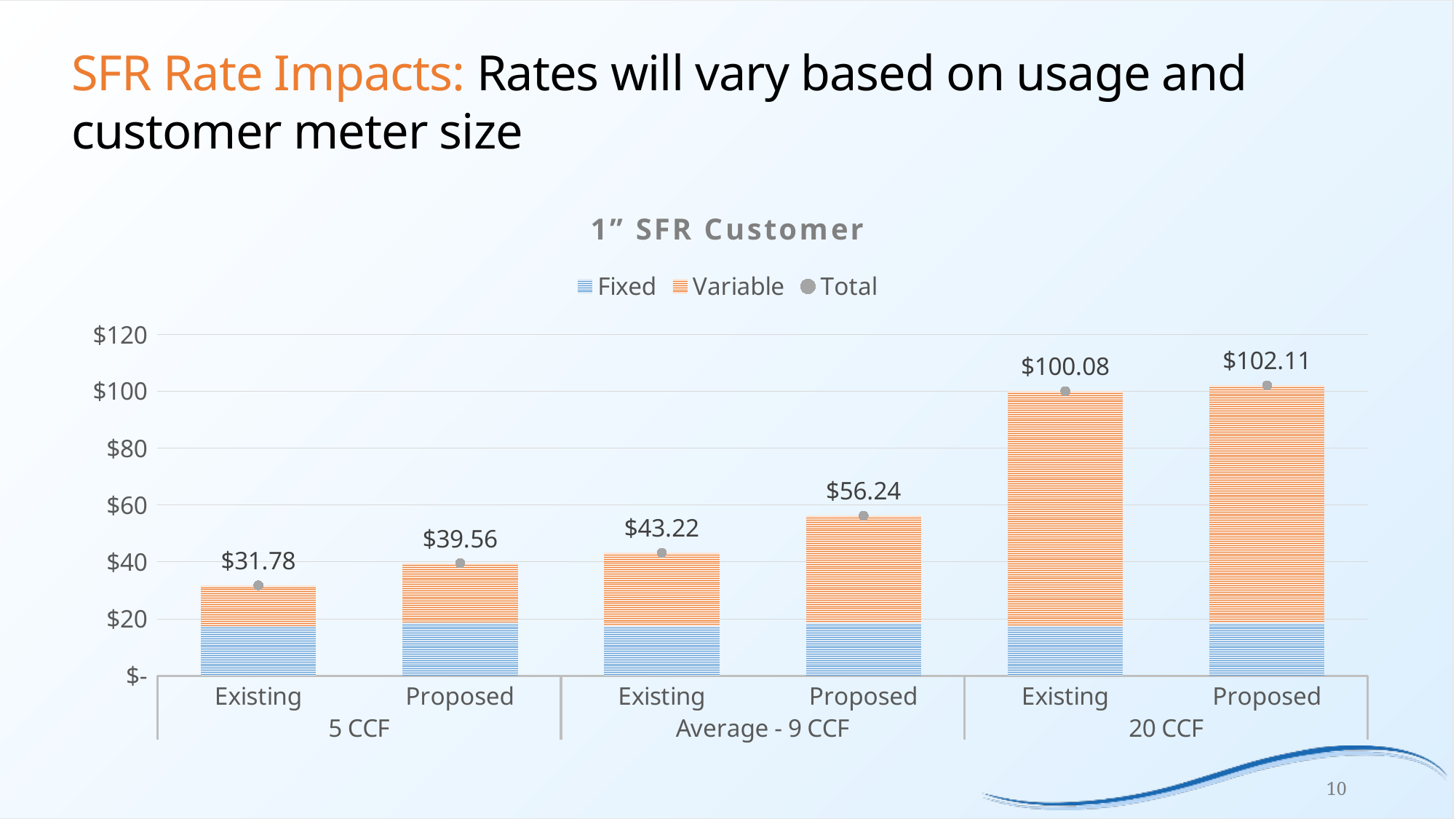
Is the Variable portion of the Existing bar in the 5 CCF group greater or less than $20? less What is the Total value for the Proposed bar in the Average - 9 CCF group? $56.24 Which bar has the highest Total value? Proposed, 20 CCF ($102.11) Which is larger, the Existing Total for 20 CCF or the Proposed Total for Average - 9 CCF? Existing Total for 20 CCF What is the Total value for the Existing bar in the 5 CCF group? $31.78 How many series does the legend list? 3 Which bar has the lowest Total value? Existing, 5 CCF ($31.78) What is the difference between the Proposed and Existing Total values in the 5 CCF group? $7.78 What is the Total value for the Existing bar in the 20 CCF group? $100.08 How many bars are plotted in the chart? 6 What is the title of the chart? 1" SFR Customer What is the difference between the Proposed and Existing Total values in the Average - 9 CCF group? $13.02